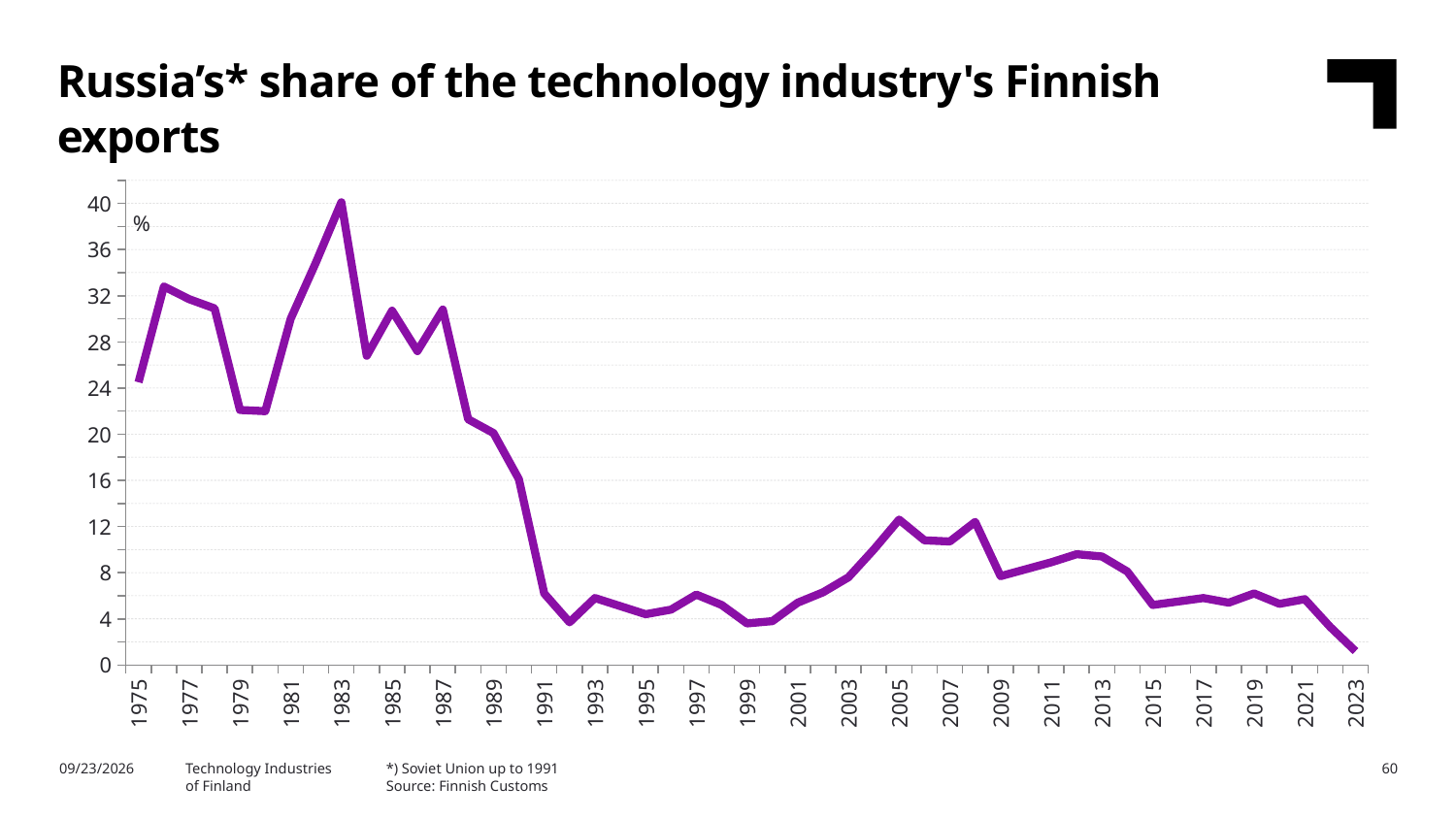
In which year is Russia's share of the technology industry's Finnish exports at its lowest? 2023 Is the value for 1983 greater or less than 36? greater Overall, does Russia's share rise or fall from 1975 to 2023? Fall According to the footnote, which entity does the series refer to up to 1991? Soviet Union What kind of chart is shown on the slide? Line chart Is the value for 1991 greater or less than 8? less Is the value for 2009 greater or less than 12? less In which year does Russia's share of the technology industry's Finnish exports reach its highest value? 1983 Which year has the larger value, 1983 or 1985? 1983 Which year has the larger value, 2005 or 2015? 2005